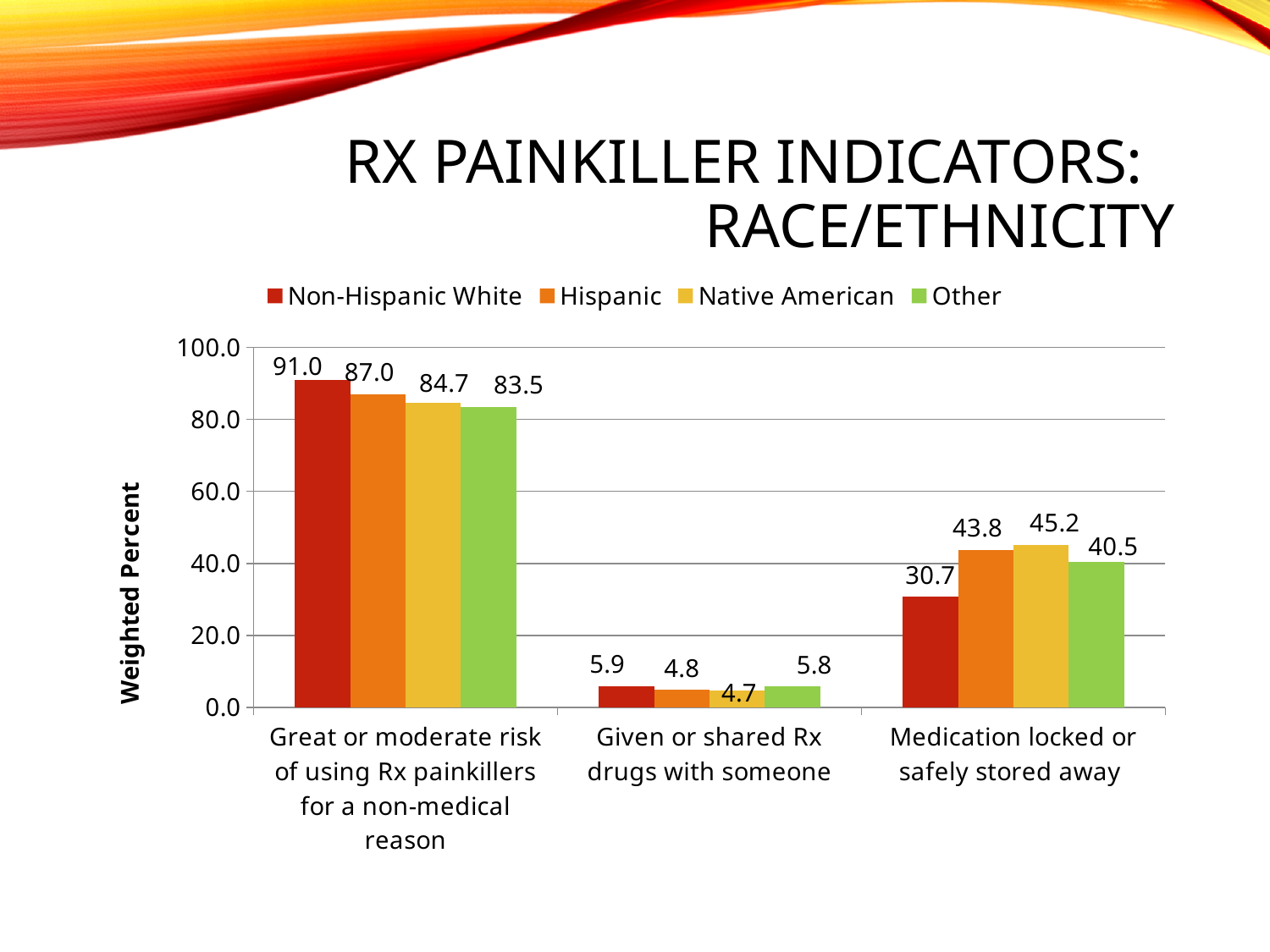
How many series does the legend list? 4 Which series has the highest value in the 'Medication locked or safely stored away' category? Native American Which series has the lowest value in the 'Given or shared Rx drugs with someone' category? Native American In the 'Medication locked or safely stored away' category, which is larger: the Hispanic value or the Other value? Hispanic What is the difference between the Non-Hispanic White and Other values in the 'Great or moderate risk of using Rx painkillers for a non-medical reason' category? 7.5 Is the value for Non-Hispanic White in the 'Medication locked or safely stored away' category greater or less than 40.0? less What kind of chart is shown on the slide? bar chart What is the label of the y axis? Weighted Percent What is the value for Hispanic in the 'Given or shared Rx drugs with someone' category? 4.8 How many categories are shown on the x axis? 3 What is the value for Non-Hispanic White in the 'Great or moderate risk of using Rx painkillers for a non-medical reason' category? 91.0 What is the value for Native American in the 'Medication locked or safely stored away' category? 45.2